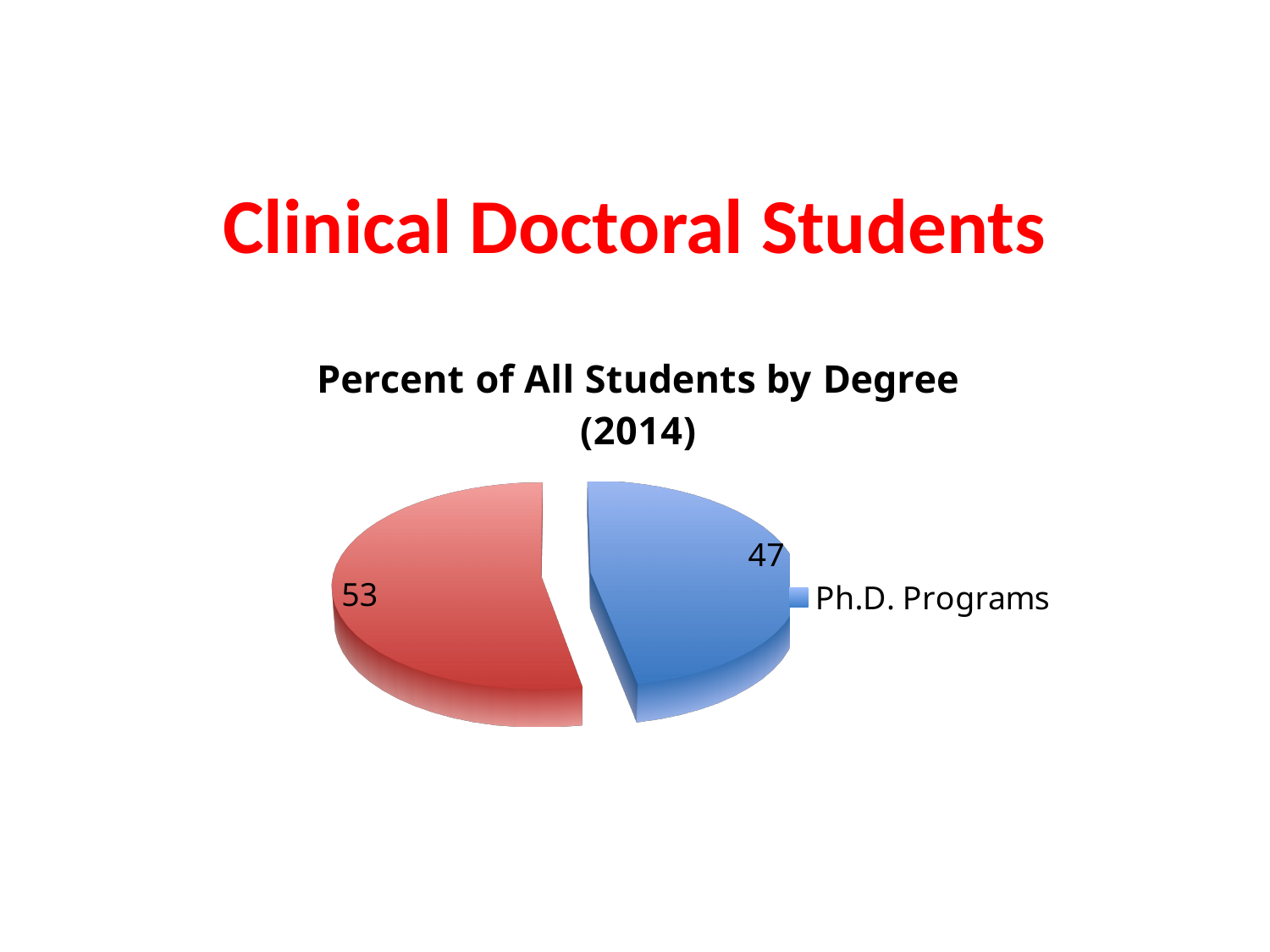
What is the total of the two values shown in the pie chart? 100 Is the value for Ph.D. Programs greater or less than 50? less Which slice is larger, the red slice or the blue Ph.D. Programs slice? the red slice What kind of chart is shown on the slide? pie chart What is the title of the chart? Percent of All Students by Degree (2014) What value is printed on the red slice of the pie chart? 53 How many slices does the pie chart have? 2 Which colour is the Ph.D. Programs slice in the pie chart? blue What is the difference between the red slice value and the Ph.D. Programs value? 6 What is the value shown for Ph.D. Programs in the pie chart? 47 Which slice has the smallest value in the pie chart? Ph.D. Programs How many entries does the legend list? 1